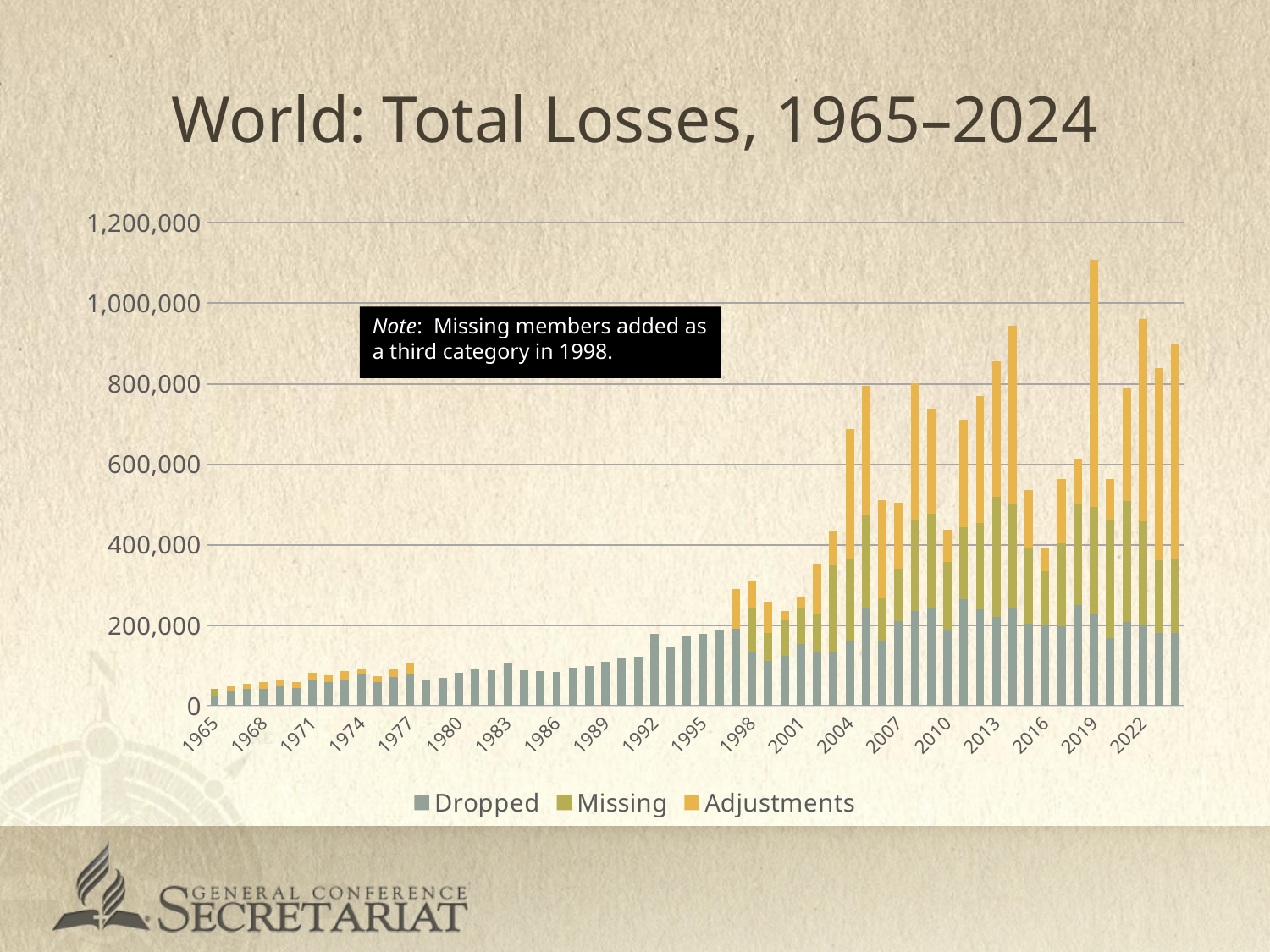
Is the tallest bar in the chart greater or less than 1,000,000? greater Which series are listed in the legend? Dropped, Missing, Adjustments What kind of chart is shown on the slide? Stacked bar chart Is the total value for 1998 greater or less than 200,000? greater Is the total value for 1965 greater or less than 200,000? less Which year has the larger total, 1965 or 2022? 2022 What is the title of the chart? World: Total Losses, 1965–2024 Do total losses generally rise or fall from 1965 to 2024? rise What is the highest value shown on the vertical axis? 1,200,000 How many series does the legend list? 3